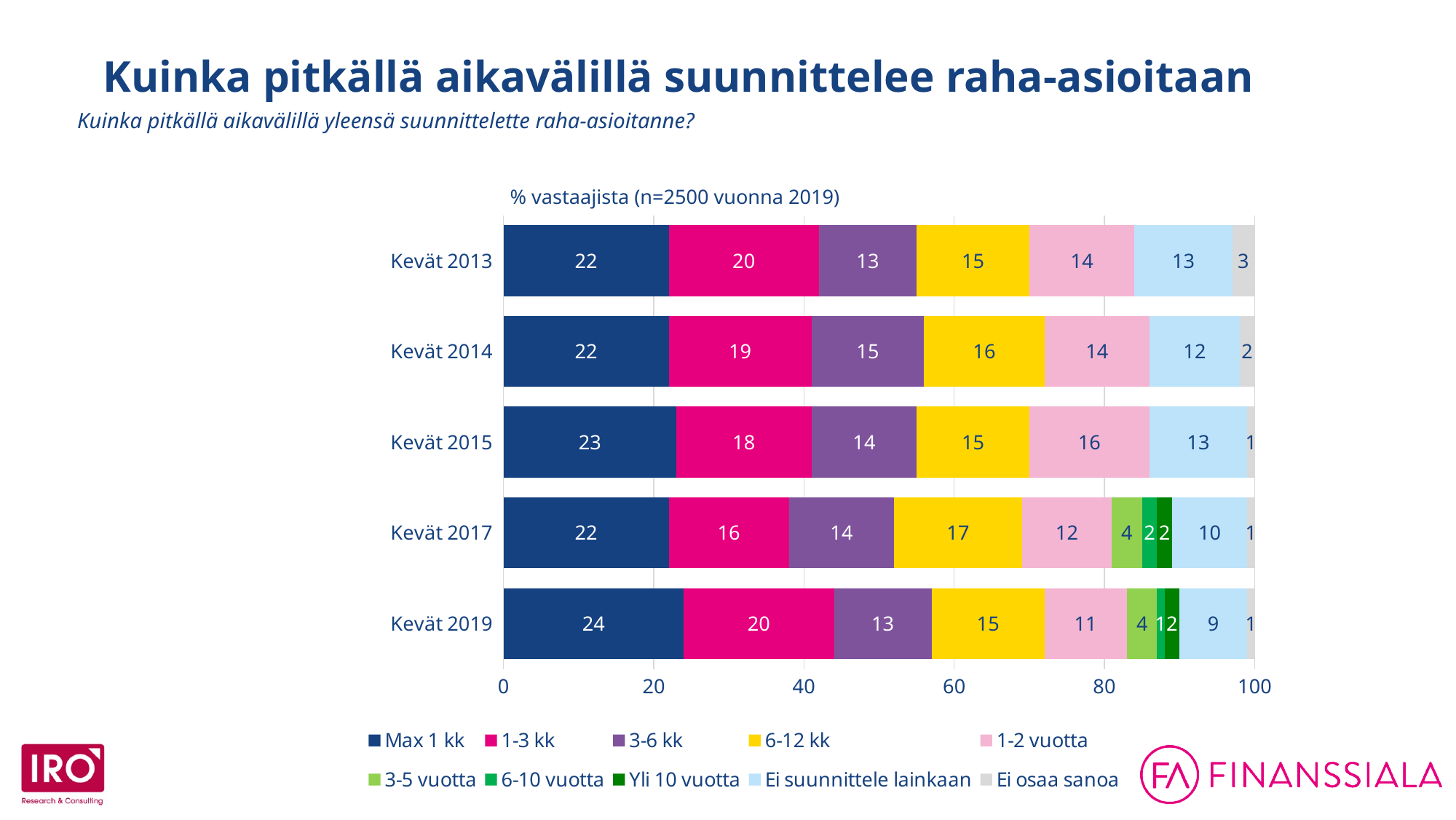
Which is larger: the '6-12 kk' value in Kevät 2017 or in Kevät 2019? Kevät 2017 What is the value for 'Max 1 kk' in Kevät 2019? 24 In which year is the 'Max 1 kk' value highest? Kevät 2019 In which year is the 'Ei suunnittele lainkaan' value lowest? Kevät 2019 What is the value for '1-2 vuotta' in Kevät 2015? 16 What is the value for 'Ei suunnittele lainkaan' in Kevät 2017? 10 What is the subtitle shown above the chart? % vastaajista (n=2500 vuonna 2019) What kind of chart is shown on the slide? stacked bar chart How many categories (survey years) are shown on the chart? 5 How many series does the legend list? 10 What is the total of the stacked bar for Kevät 2014? 100 What is the difference between the '1-3 kk' values for Kevät 2013 and Kevät 2017? 4